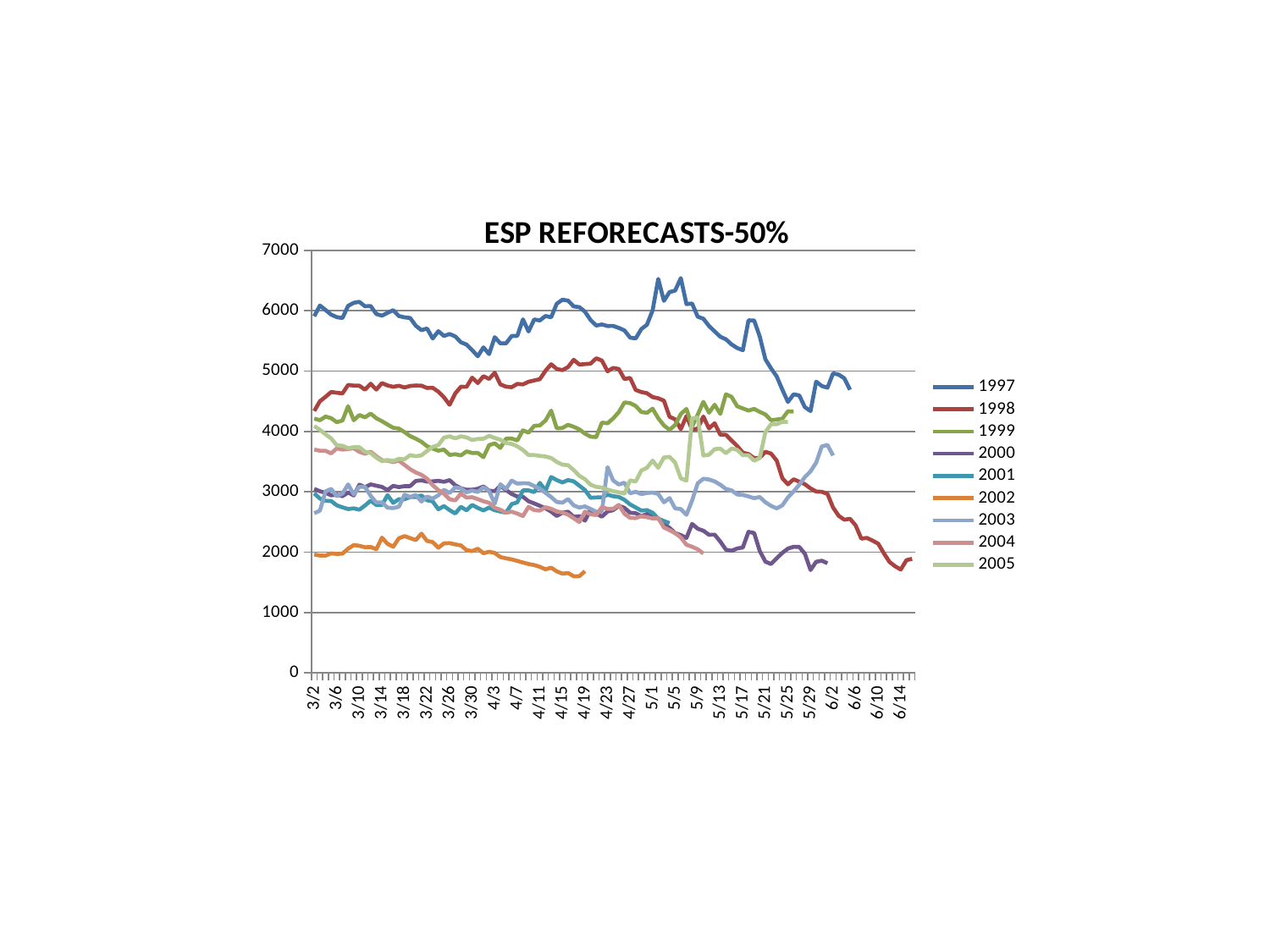
At 3/2, which series has the larger value, 1997 or 1998? 1997 What colour is the line for the 2002 series? orange Is the value for 2002 at 4/19 greater or less than 2000? less Is the value for 1998 at 6/14 greater or less than 3000? less Is the highest value of the 1997 series greater or less than 6000? greater What is the title of the chart? ESP REFORECASTS-50% How many series does the legend list? 9 Which series has the highest values on the chart? 1997 Does the 1998 series rise or fall overall from 3/2 to 6/14? fall Which series has the lowest values on the chart? 2002 What kind of chart is shown on the slide? line chart